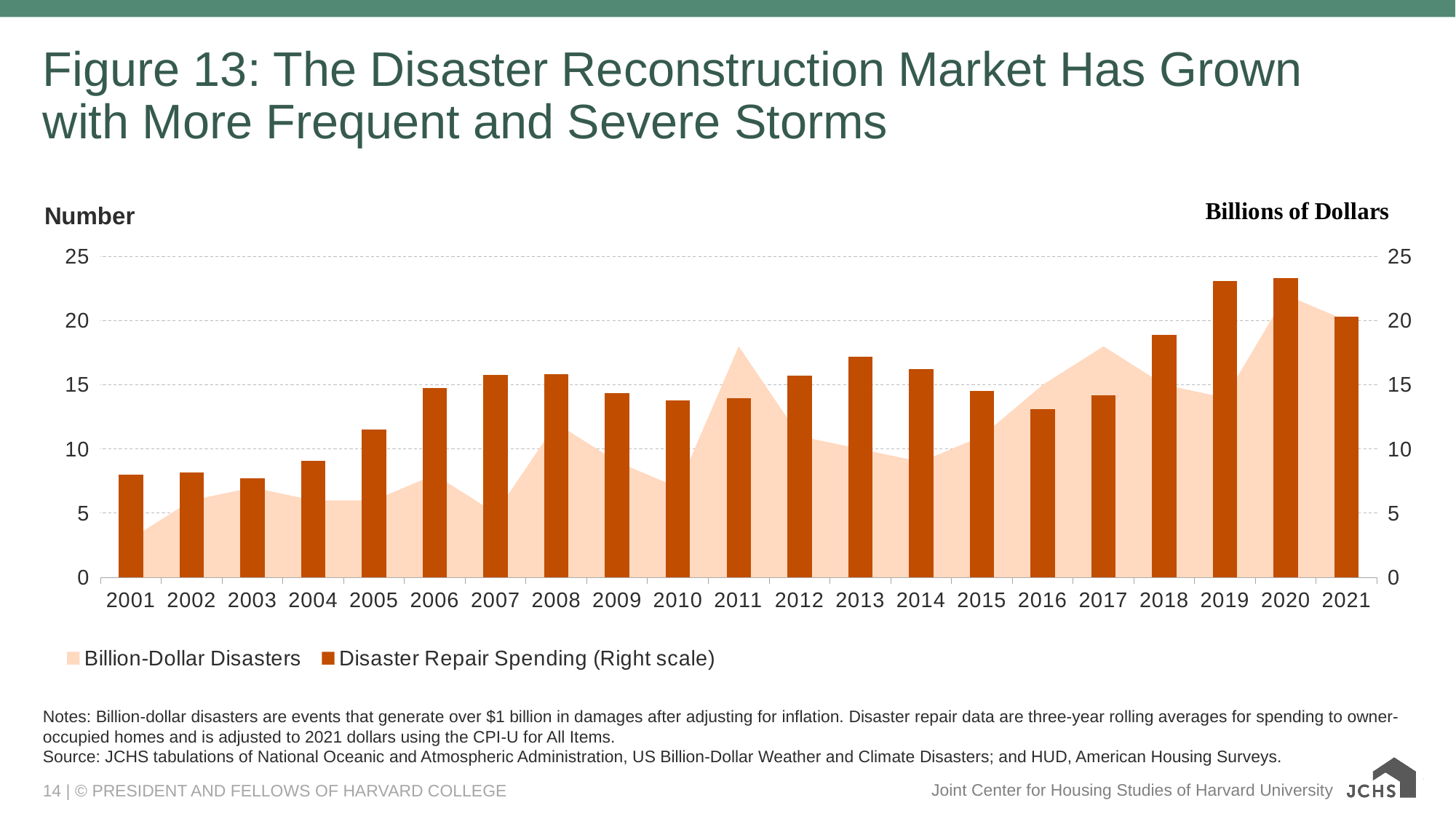
Is the Disaster Repair Spending value for 2013 greater or less than 15? greater Is the Billion-Dollar Disasters value for 2020 greater or less than 20? greater Which is larger, Disaster Repair Spending in 2019 or in 2001? 2019 What kind of chart is shown on the slide? A combined bar and area chart Is the Billion-Dollar Disasters value for 2001 greater or less than 5? less Which year has the highest number of Billion-Dollar Disasters? 2020 How many years are shown on the x axis? 21 Which series is plotted on the right scale? Disaster Repair Spending Do the Disaster Repair Spending values generally rise or fall from 2001 to 2021? rise How many series does the legend list? 2